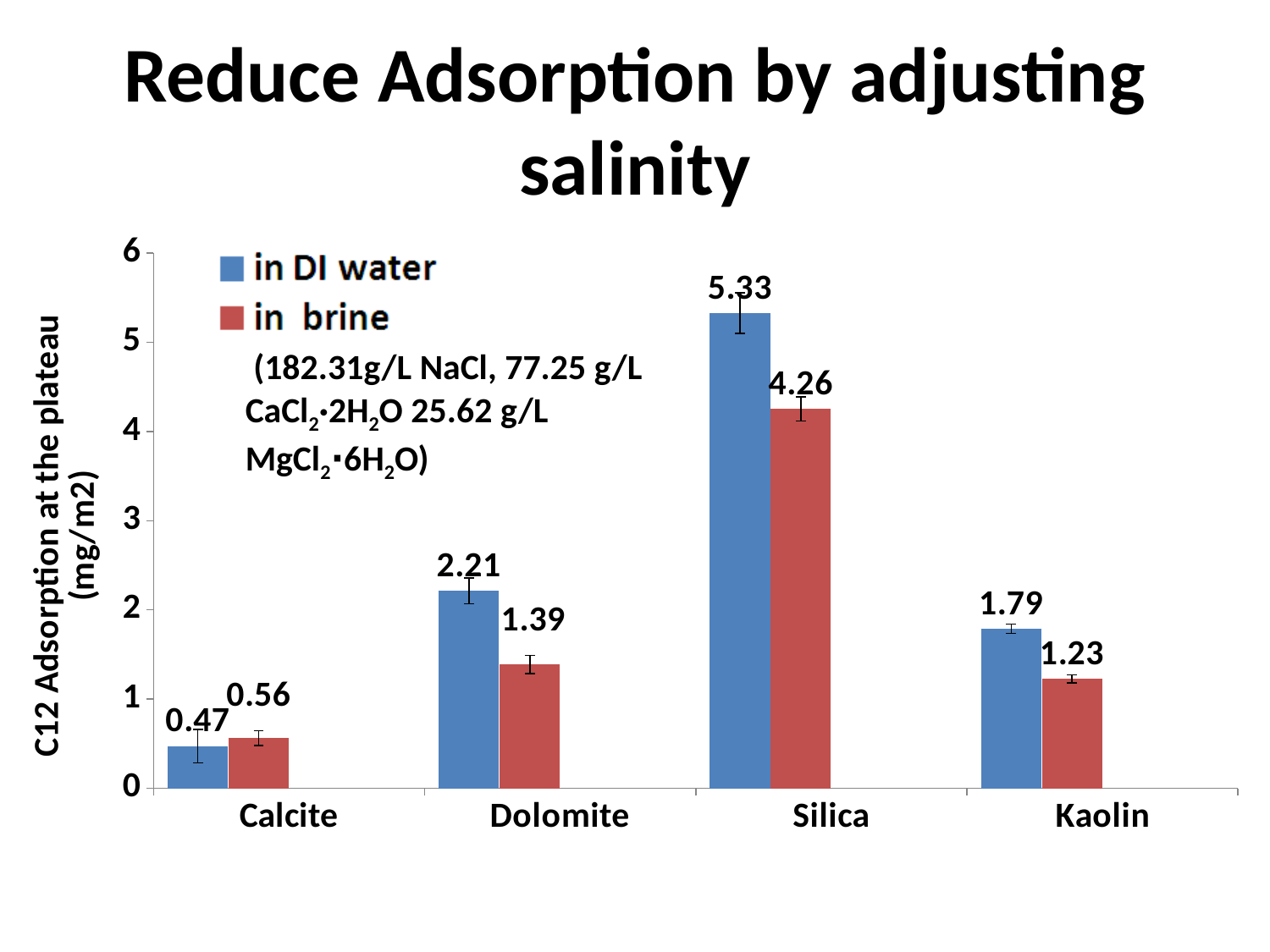
What is the C12 adsorption for Calcite in brine? 0.56 What type of chart is shown on the slide? bar chart What is the C12 adsorption for Silica in DI water? 5.33 Which mineral has the highest C12 adsorption in DI water? Silica How many minerals are shown on the x axis? 4 Which mineral has the lowest C12 adsorption in brine? Calcite What is the difference between the DI water and brine adsorption values for Silica? 1.07 How many series does the legend list? 2 What is the C12 adsorption for Kaolin in brine? 1.23 For Calcite, is the adsorption higher in DI water or in brine? in brine Is the value for Silica in brine greater or less than 4? greater What is the difference between the DI water and brine adsorption values for Dolomite? 0.82